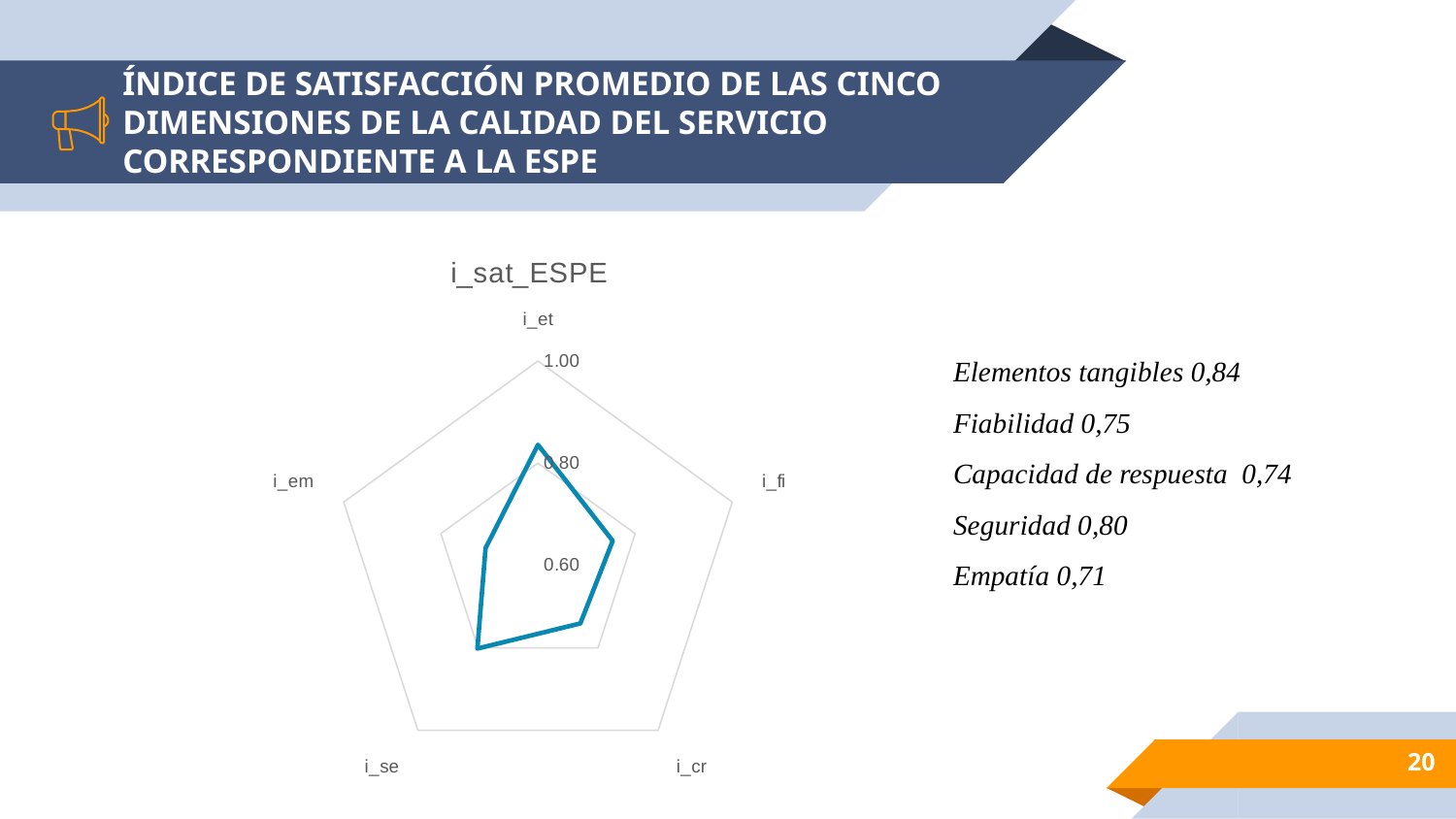
What is the title of the chart? i_sat_ESPE According to the slide, what is the satisfaction index for Empatía? 0,71 Is the value for i_cr greater or less than 0.60? greater Is the value for i_em greater or less than 0.80? less Which dimension has the highest value on the radar chart? i_et Is the value for i_et greater or less than 0.80? greater Which is larger on the radar chart, the value for i_et or the value for i_em? i_et What is the highest tick value shown on the radar chart's axis? 1.00 How many dimensions (axes) does the radar chart have? 5 What type of chart is shown on the slide? Radar chart According to the slide, what is the satisfaction index for Elementos tangibles? 0,84